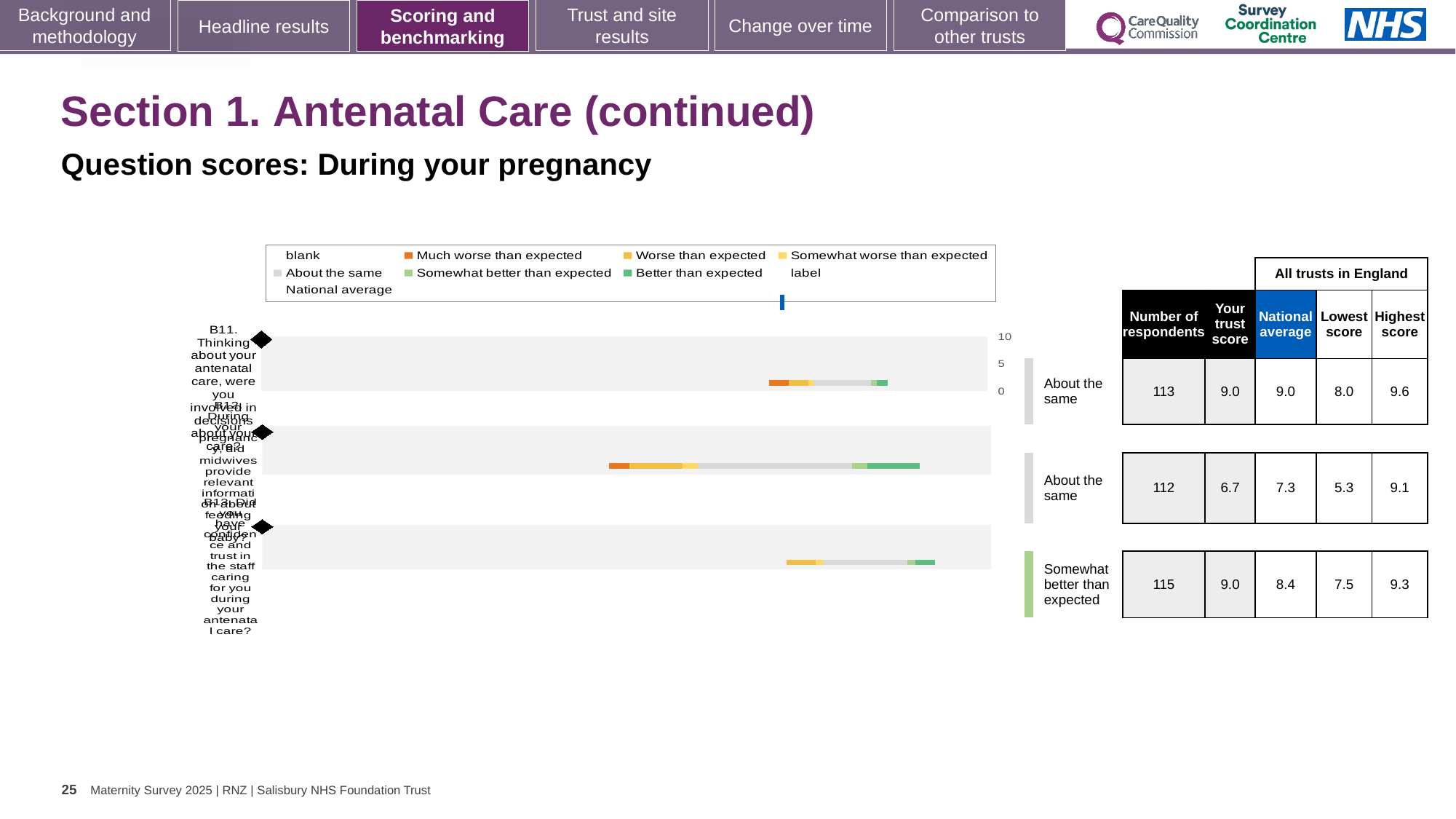
How many questions (rows) are plotted in the chart? 3 What is the highest score among all trusts in England for question B11? 9.6 What is the trust score for question B12 (did midwives provide relevant information about feeding your baby)? 6.7 How many respondents answered question B11 (were you involved in decisions about your care)? 113 What benchmark category is shown for question B13? Somewhat better than expected What colour is used in the legend for 'Much worse than expected'? orange For question B13, which is larger: the trust score or the national average? the trust score Which question has the lowest trust score? B12 What is the difference between the national average and the trust score for question B12? 0.6 What is the national average for question B13 (did you have confidence and trust in the staff caring for you during your antenatal care)? 8.4 Which question has the highest number of respondents? B13 What type of chart is shown on the slide? bar chart